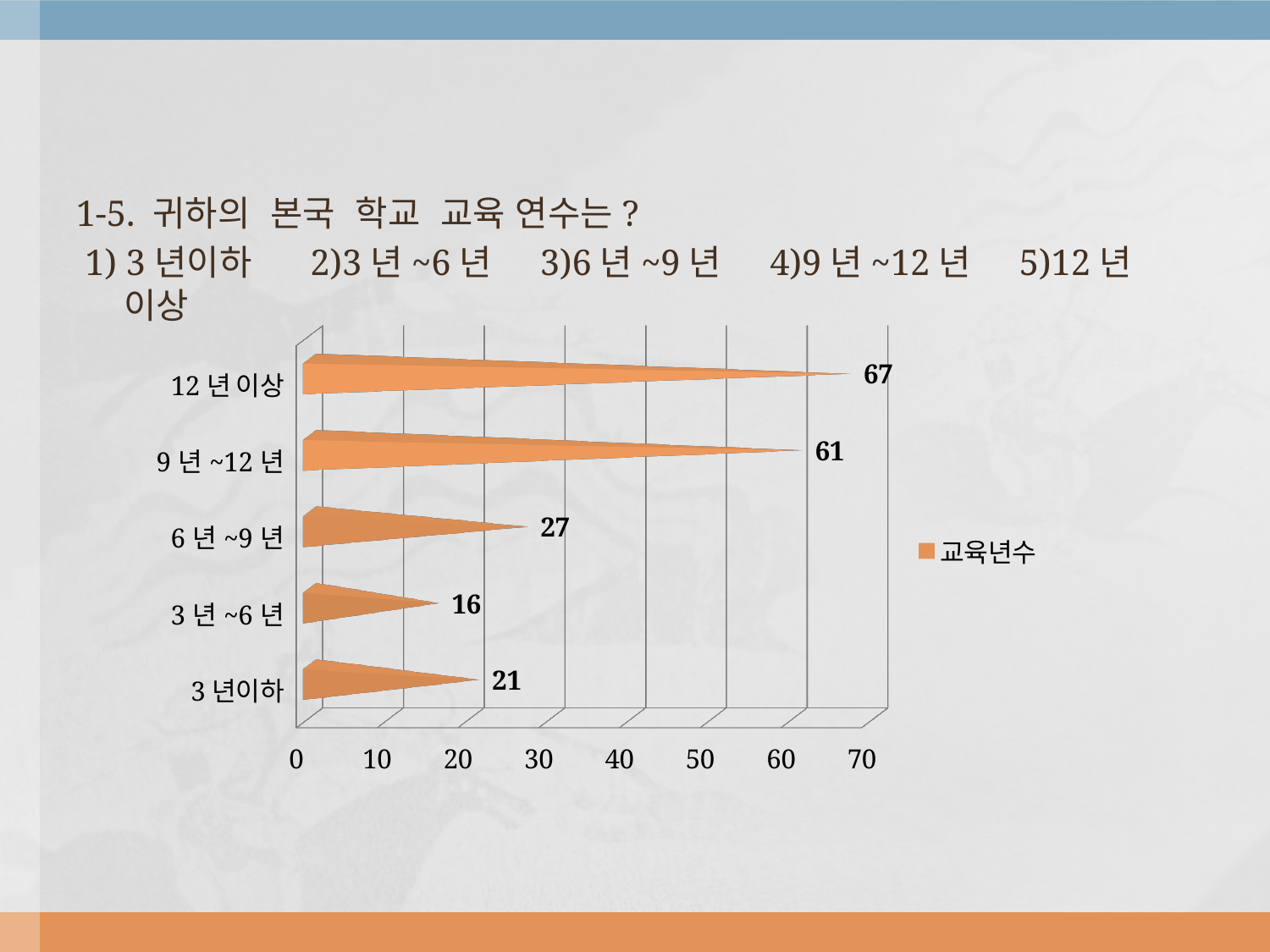
What kind of chart is shown on the slide? bar chart Which category has the highest value? 12 년 이상 What is the value for 6 년 ~9 년? 27 What is the value for 3 년 ~6 년? 16 Which category has the lowest value? 3 년 ~6 년 What is the name of the series shown in the legend? 교육년수 What is the difference between the values for 12 년 이상 and 9 년 ~12 년? 6 How many categories are shown on the chart? 5 How many series does the legend list? 1 What is the difference between the values for 6 년 ~9 년 and 3 년이하? 6 What is the value for 12 년 이상? 67 Which is larger, the value for 3 년이하 or the value for 3 년 ~6 년? 3 년이하